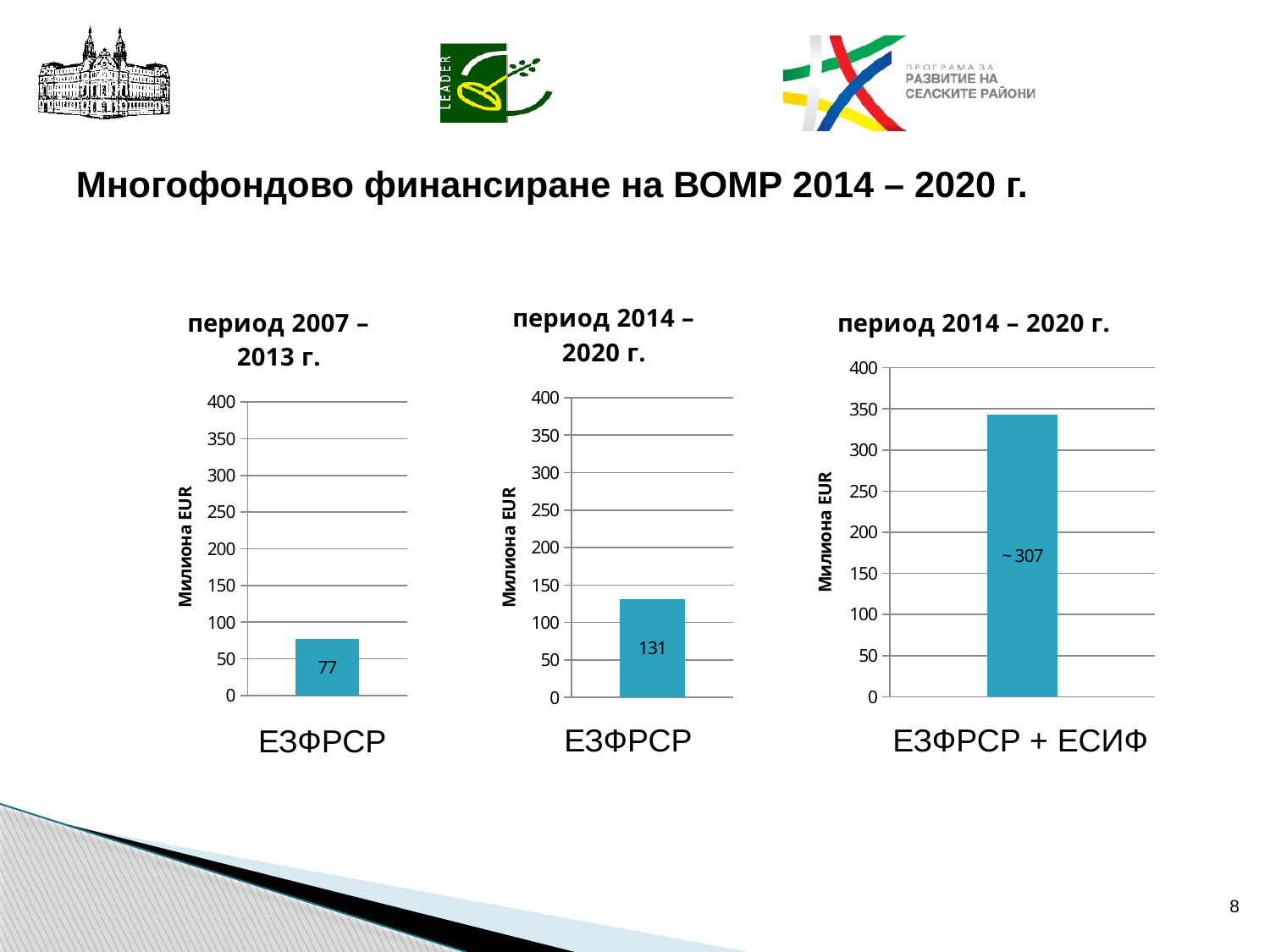
What is the y-axis label of the middle chart (период 2014 – 2020 г., ЕЗФРСР)? Милиона EUR In the right chart (ЕЗФРСР + ЕСИФ), is the value of the bar greater or less than 300? greater What is the category label shown under the right chart? ЕЗФРСР + ЕСИФ How many bars are plotted in the left chart (период 2007 – 2013 г.)? 1 Which of the three charts on the slide has the tallest bar? The right chart (ЕЗФРСР + ЕСИФ) In the left chart (период 2007 – 2013 г.), is the value of the bar greater or less than 100? less In the left chart (период 2007 – 2013 г.), what is the value of the ЕЗФРСР bar? 77 In the middle chart (период 2014 – 2020 г., ЕЗФРСР), what is the value of the bar? 131 What is the difference between the ЕЗФРСР value in the middle chart (131) and the ЕЗФРСР value in the left chart (77)? 54 In the middle chart (период 2014 – 2020 г., ЕЗФРСР), is the value of the bar greater or less than 100? greater What type of chart is used in the left chart (период 2007 – 2013 г.)? Bar chart Which is larger: the ЕЗФРСР bar in the left chart (период 2007 – 2013 г.) or the ЕЗФРСР bar in the middle chart (период 2014 – 2020 г.)? The middle chart (131)